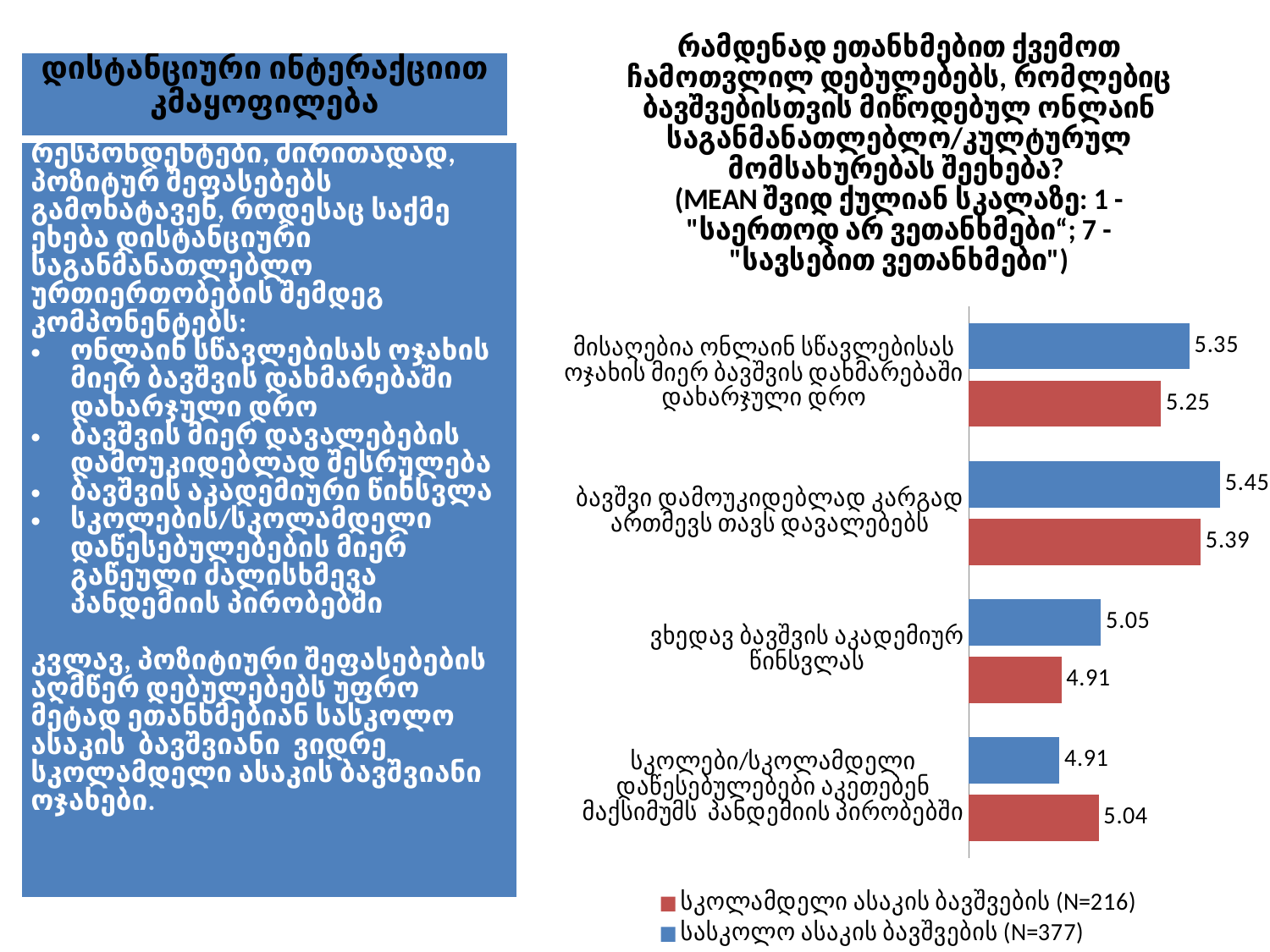
What is the value for preschool-age children (სკოლამდელი ასაკის ბავშვების, N=216) for the statement "ვხედავ ბავშვის აკადემიურ წინსვლას"? 4.91 Which colour represents the series "სასკოლო ასაკის ბავშვების (N=377)"? blue Which statement has the lowest value for preschool-age children (N=216)? ვხედავ ბავშვის აკადემიურ წინსვლას How many statements (categories) are shown in the chart? 4 How many series does the chart legend list? 2 What is the value for school-age children (N=377) for the statement "მისაღებია ონლაინ სწავლებისას ოჯახის მიერ ბავშვის დახმარებაში დახარჯული დრო"? 5.35 Which statement has the highest value for school-age children (N=377)? ბავშვი დამოუკიდებლად კარგად ართმევს თავს დავალებებს What is the value for preschool-age children (N=216) for the statement "სკოლები/სკოლამდელი დაწესებულებები აკეთებენ მაქსიმუმს პანდემიის პირობებში"? 5.04 What is the difference between the school-age (5.05) and preschool-age (4.91) values for "ვხედავ ბავშვის აკადემიურ წინსვლას"? 0.14 What is the value for school-age children (სასკოლო ასაკის ბავშვების, N=377) for the statement "ბავშვი დამოუკიდებლად კარგად ართმევს თავს დავალებებს"? 5.45 For the statement "სკოლები/სკოლამდელი დაწესებულებები აკეთებენ მაქსიმუმს პანდემიის პირობებში", which group has the larger value: school-age (N=377) or preschool-age (N=216) children? preschool-age (N=216) What type of chart is shown on the slide? bar chart